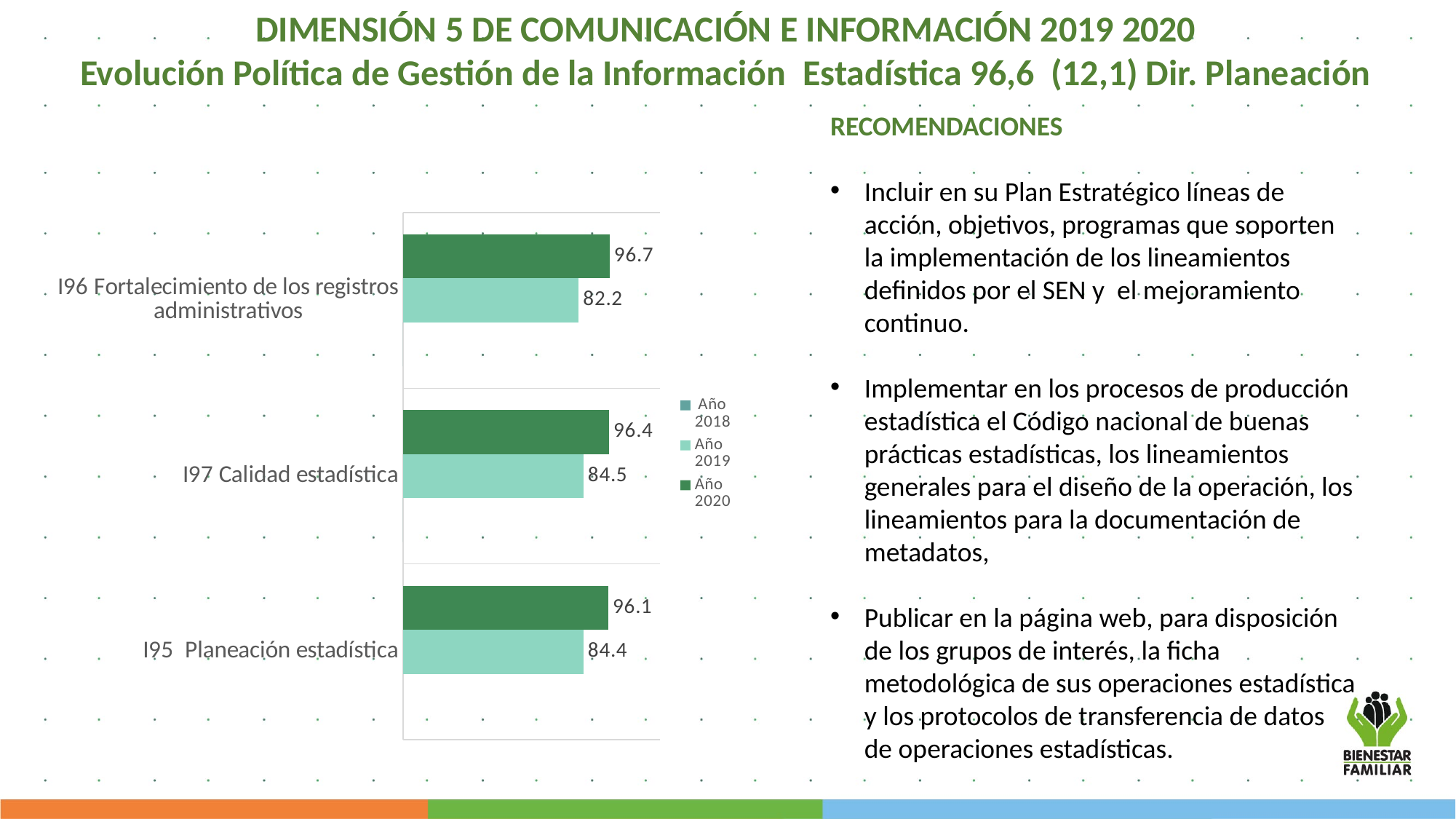
What kind of chart is shown on the slide? Bar chart How many series does the legend list? 3 What is the Año 2019 value for I95 Planeación estadística? 84.4 How many categories are shown on the chart? 3 Which category has the lowest Año 2019 value? I96 Fortalecimiento de los registros administrativos Which category has the highest Año 2020 value? I96 Fortalecimiento de los registros administrativos Which is larger for I95 Planeación estadística, the Año 2019 value or the Año 2020 value? Año 2020 What is the difference between the Año 2020 and Año 2019 values for I97 Calidad estadística? 11.9 What is the Año 2020 value for I96 Fortalecimiento de los registros administrativos? 96.7 What is the Año 2019 value for I97 Calidad estadística? 84.5 What is the difference between the Año 2020 and Año 2019 values for I96 Fortalecimiento de los registros administrativos? 14.5 What is the Año 2020 value for I95 Planeación estadística? 96.1